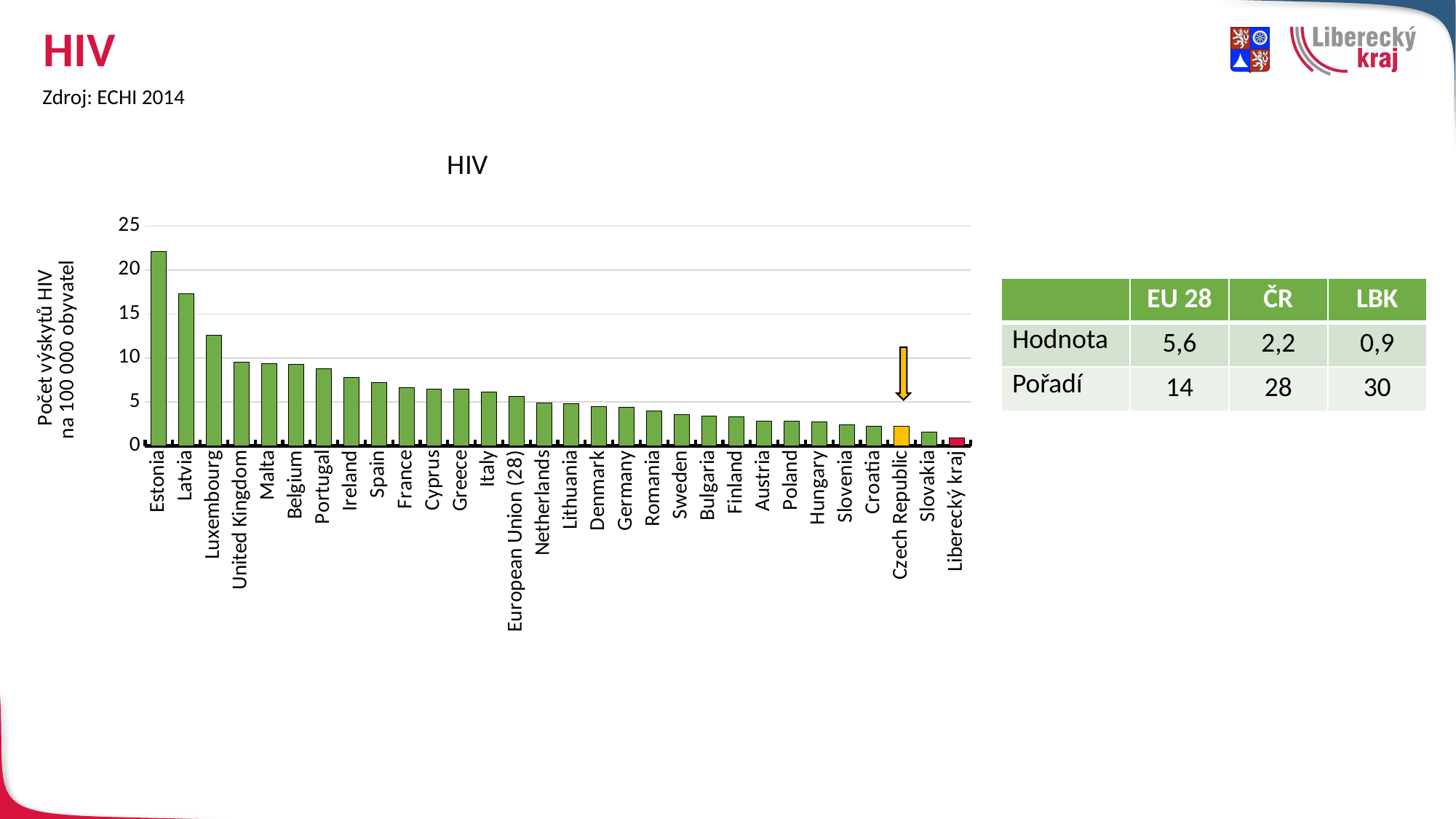
Do the values rise or fall moving from left to right along the x axis? fall Which category has the highest value in the HIV chart? Estonia Is the value for Luxembourg greater or less than 10? greater What kind of chart is shown on the slide? bar chart Which has a larger value, Latvia or Luxembourg? Latvia What is the title of the chart? HIV Is the value for United Kingdom greater or less than 10? less According to the table, what is the value (Hodnota) for ČR? 2,2 Is the value for Estonia greater or less than 20? greater Which category has the lowest value in the HIV chart? Liberecký kraj How many bars (categories) are plotted in the HIV chart? 30